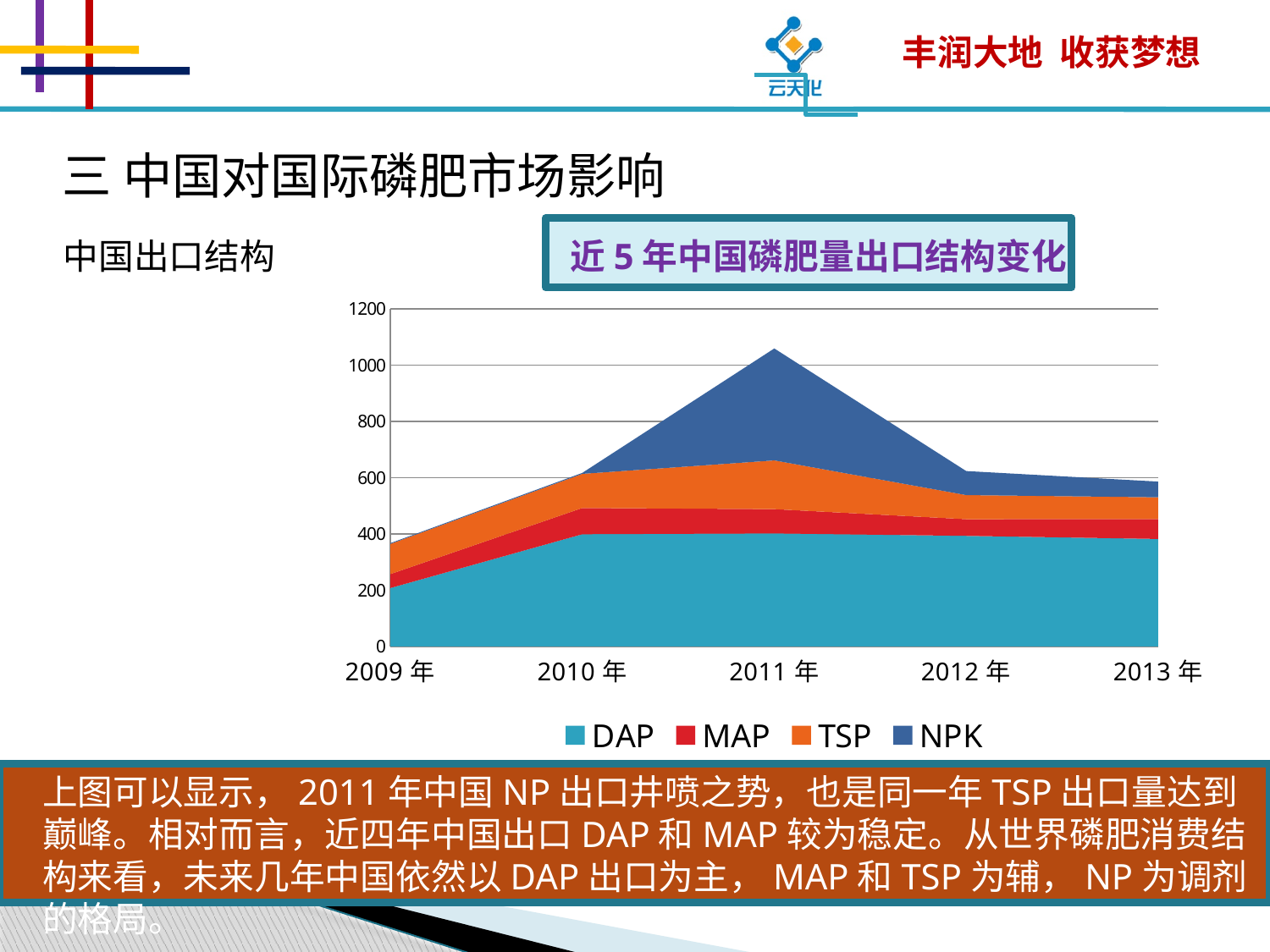
How many series does the chart legend list? 4 Is the total stacked value for 2009年 greater or less than 400? less In which year is the total stacked export volume lowest? 2009年 How many years are shown on the x axis of the chart? 5 Is the total stacked value for 2011年 greater or less than 1000? greater Which series are listed in the chart legend? DAP, MAP, TSP, NPK Does the total stacked value rise or fall from 2011年 to 2013年? fall In which year is the total stacked export volume highest? 2011年 What is the title of the chart? 近5年中国磷肥量出口结构变化 Which year has the largest NPK band in the chart? 2011年 What kind of chart is shown on the slide? Stacked area chart